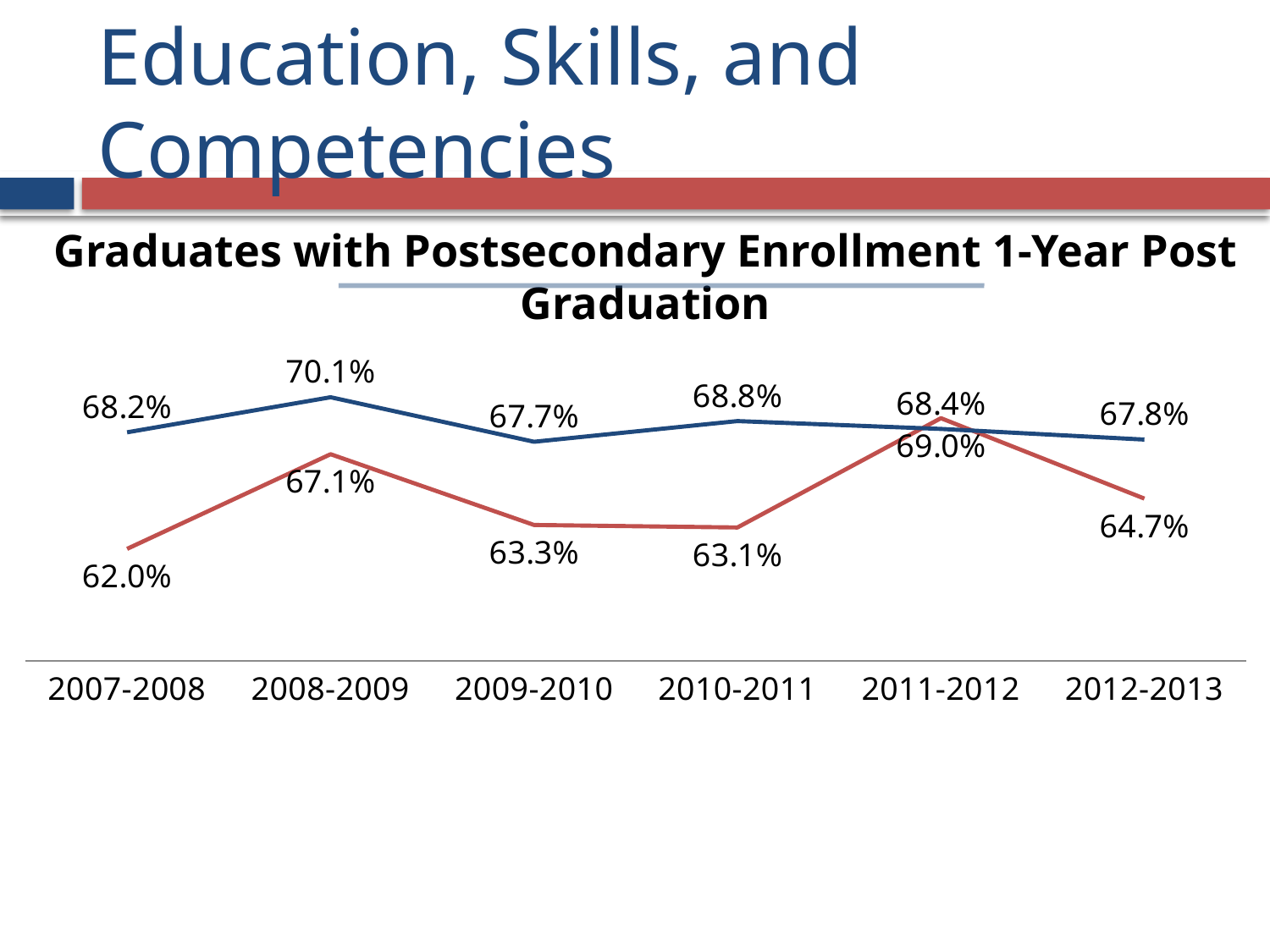
What is the title of the chart? Graduates with Postsecondary Enrollment 1-Year Post Graduation In which school year does the red line have its lowest value? 2007-2008 How many school years are shown on the x axis of the chart? 6 What type of chart is shown on the slide? Line chart What is the value of the blue line for 2010-2011? 68.8% In which school year does the red line reach its highest value? 2011-2012 What is the value of the blue line for 2008-2009? 70.1% What is the value of the red line for 2012-2013? 64.7% In which school year does the blue line reach its highest value? 2008-2009 In 2011-2012, which line has the higher value, the blue line or the red line? The red line What is the value of the red line for 2007-2008? 62.0% What is the difference between the blue line and the red line in 2007-2008? 6.2%